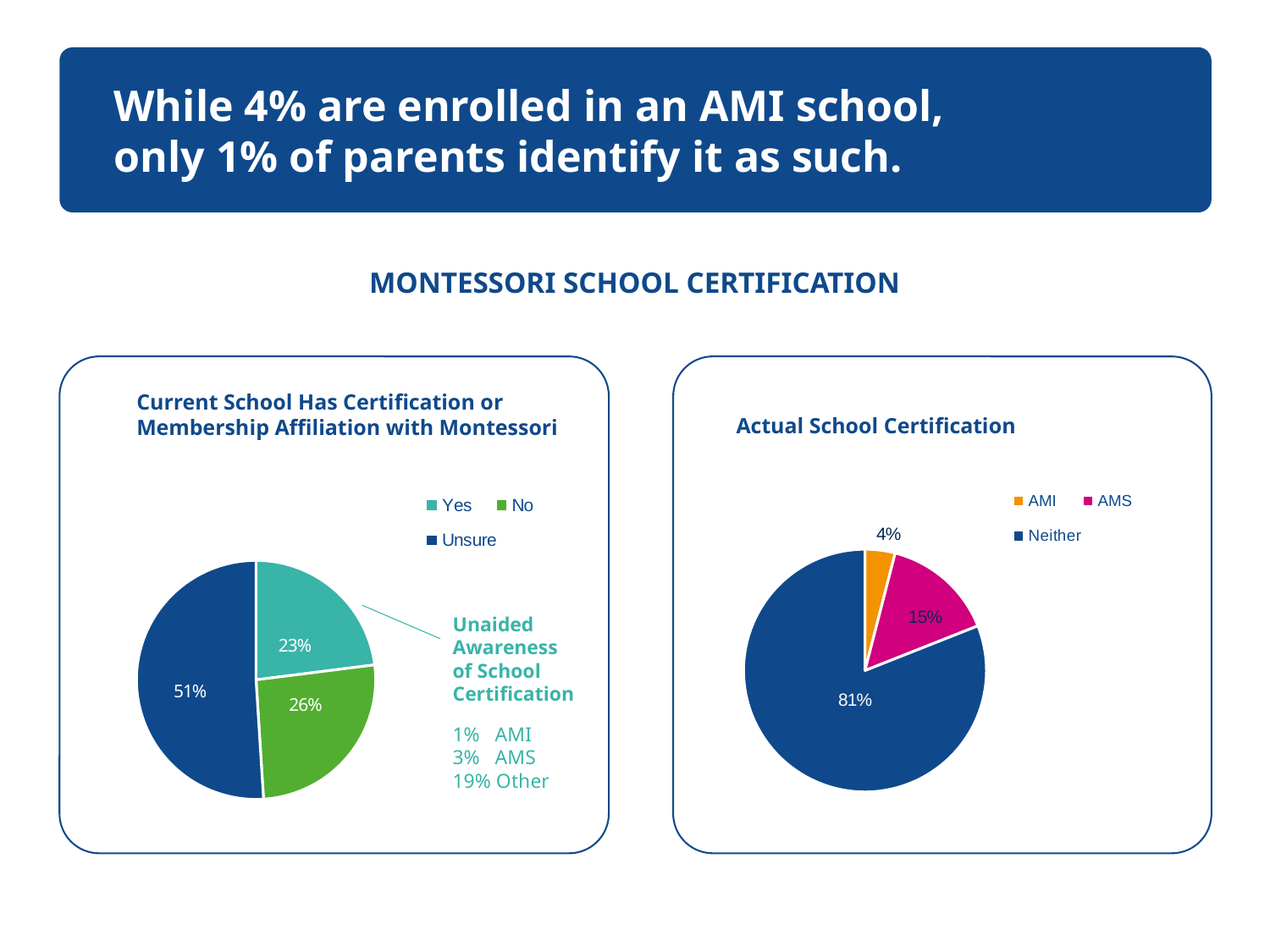
In the 'Actual School Certification' chart, which category has the largest share? Neither In the 'Current School Has Certification or Membership Affiliation with Montessori' chart, which response has the largest share? Unsure In the 'Actual School Certification' chart, what is the difference between the Neither and AMS shares? 66% In the 'Actual School Certification' chart, what percentage of schools are AMS certified? 15% In the 'Current School Has Certification or Membership Affiliation with Montessori' chart, what is the difference between the No and Yes shares? 3% In the 'Current School Has Certification or Membership Affiliation with Montessori' chart, which response has the smallest share? Yes In the 'Current School Has Certification or Membership Affiliation with Montessori' chart, what percentage answered Yes? 23% What type of chart is the 'Actual School Certification' chart? Pie chart In the 'Actual School Certification' chart, what percentage of schools are AMI certified? 4% In the 'Actual School Certification' chart, which is larger, AMI or AMS? AMS How many entries does the legend of the 'Current School Has Certification or Membership Affiliation with Montessori' chart list? 3 In the 'Current School Has Certification or Membership Affiliation with Montessori' chart, what percentage answered Unsure? 51%